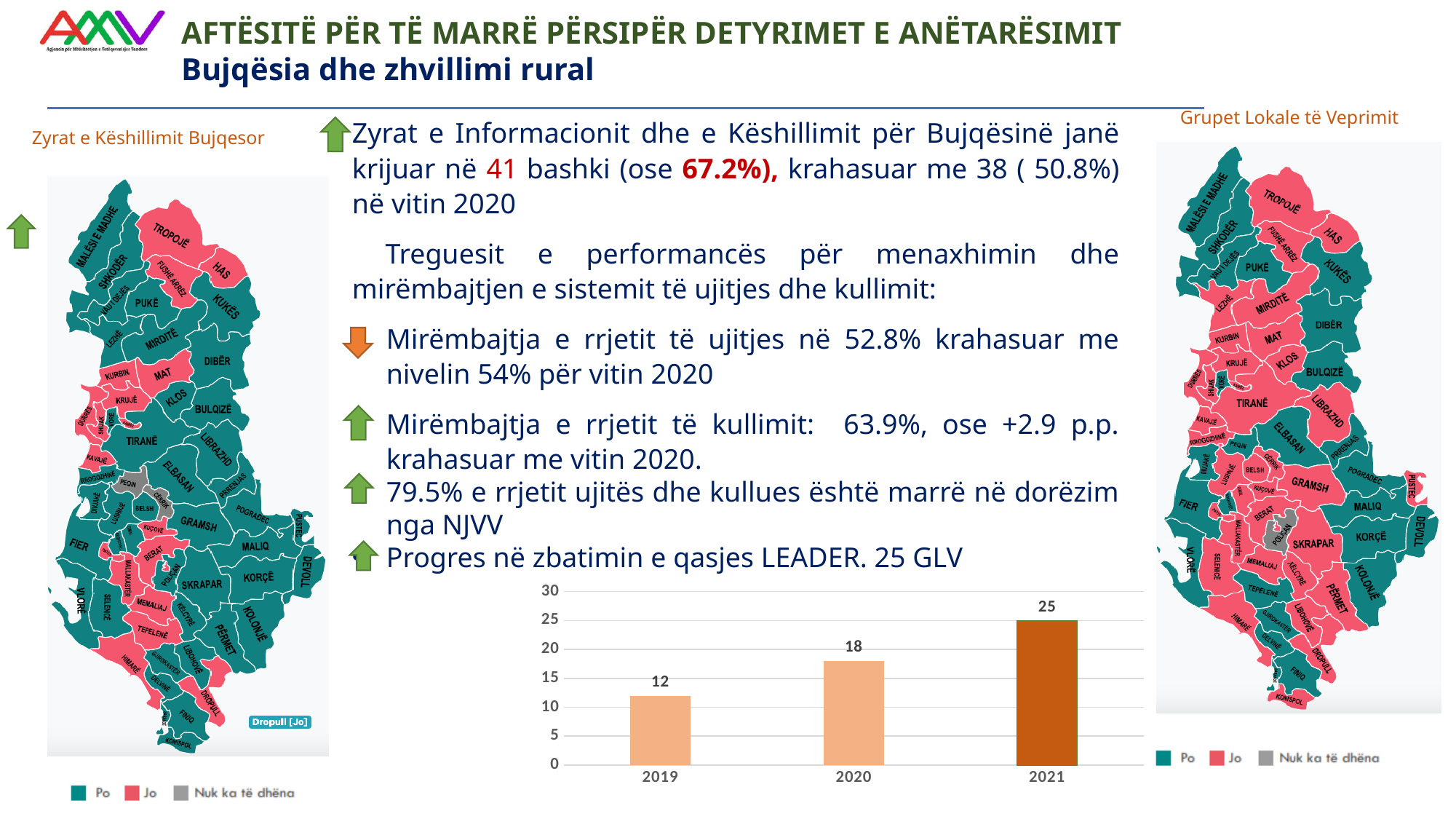
What is the value for 2020 in the bar chart? 18 How many years are shown on the x axis of the bar chart? 3 Which year has the lowest value in the bar chart? 2019 What kind of chart is shown at the bottom centre of the slide? bar chart What is the difference between the values for 2021 and 2020 in the bar chart? 7 What is the value for 2019 in the bar chart? 12 What is the value for 2021 in the bar chart? 25 What is the difference between the values for 2020 and 2019 in the bar chart? 6 Do the values in the bar chart rise or fall from 2019 to 2021? rise Which is larger in the bar chart, the value for 2019 or the value for 2020? 2020 Is the value for 2021 in the bar chart greater or less than 20? greater Which year has the highest value in the bar chart? 2021